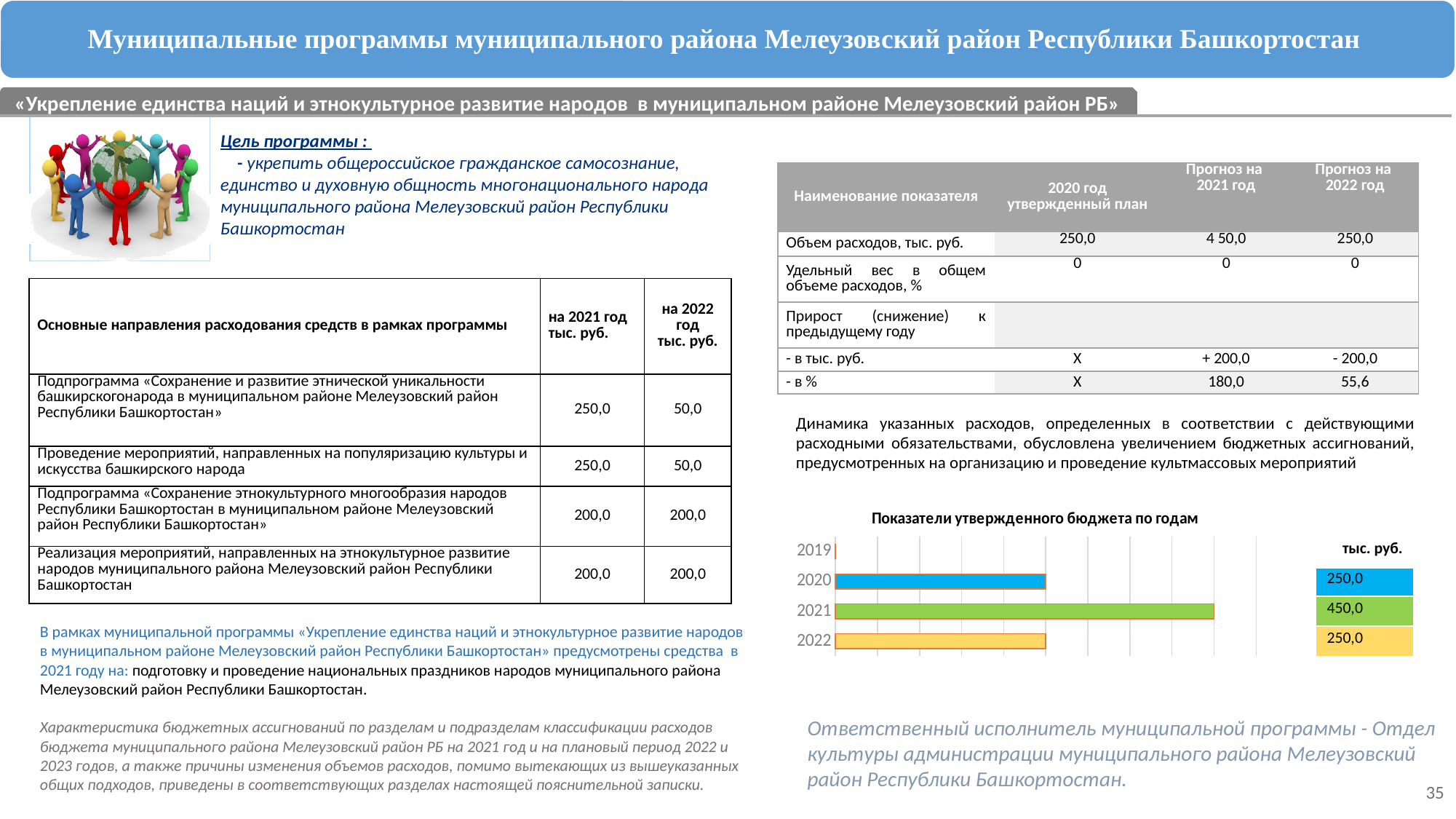
In the chart «Показатели утвержденного бюджета по годам», what is the value for 2022? 250,0 How many years are plotted in the chart «Показатели утвержденного бюджета по годам»? 4 Which year has the lowest value in the chart «Показатели утвержденного бюджета по годам»? 2019 What kind of chart is shown under the title «Показатели утвержденного бюджета по годам»? bar chart In the chart «Показатели утвержденного бюджета по годам», does the value rise or fall from 2021 to 2022? fall In the chart «Показатели утвержденного бюджета по годам», which is larger: the value for 2021 or the value for 2022? 2021 What unit is indicated next to the chart «Показатели утвержденного бюджета по годам»? тыс. руб. Which year has the highest value in the chart «Показатели утвержденного бюджета по годам»? 2021 In the chart «Показатели утвержденного бюджета по годам», what is the difference between the values for 2021 and 2020? 200,0 What colour is the bar for 2021 in the chart «Показатели утвержденного бюджета по годам»? green In the chart «Показатели утвержденного бюджета по годам», what is the value for 2020? 250,0 In the chart «Показатели утвержденного бюджета по годам», what is the value for 2021? 450,0